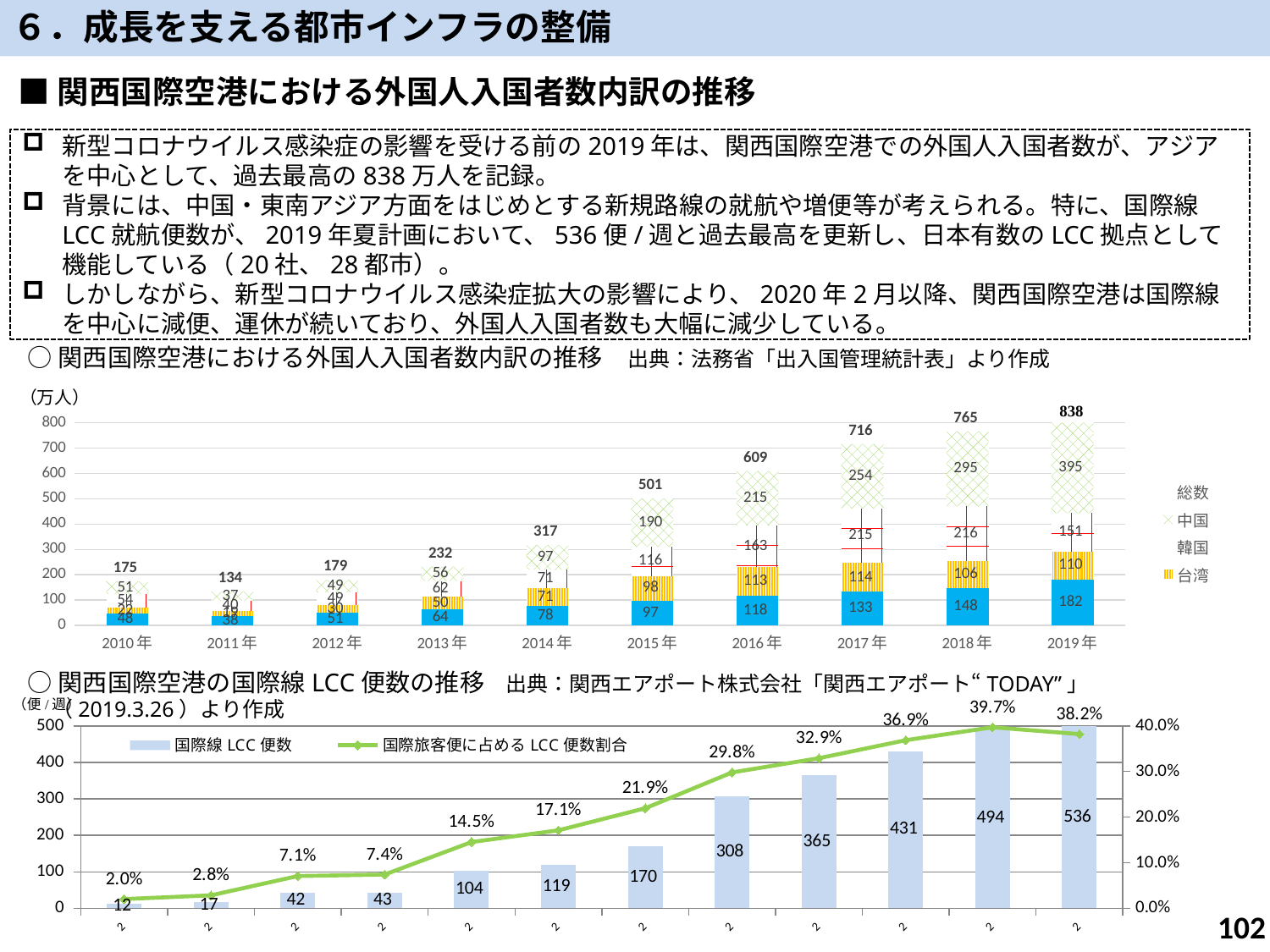
In the top chart, what is the value for 中国 in 2019年? 395 In the top chart, which is larger in 2017年, the value for 中国 or the value for 韓国? 中国 In the bottom chart (関西国際空港の国際線LCC便数の推移), what is the highest value of 国際線LCC便数 shown? 536 What kind of chart is the top chart? Stacked bar chart In the top chart, which year has the lowest total number of foreign entrants? 2011年 In the bottom chart, what is the highest value of 国際旅客便に占めるLCC便数割合 shown? 39.7% How many series does the legend of the bottom chart list? 2 In the top chart, which year has the highest total number of foreign entrants? 2019年 In the top chart (関西国際空港における外国人入国者数内訳の推移), what is the total (総数) for 2019年? 838 In the top chart, what is the difference between the totals for 2019年 and 2018年? 73 In the top chart, do the totals rise or fall from 2013年 to 2019年? Rise In the top chart, how many years are shown on the x axis? 10